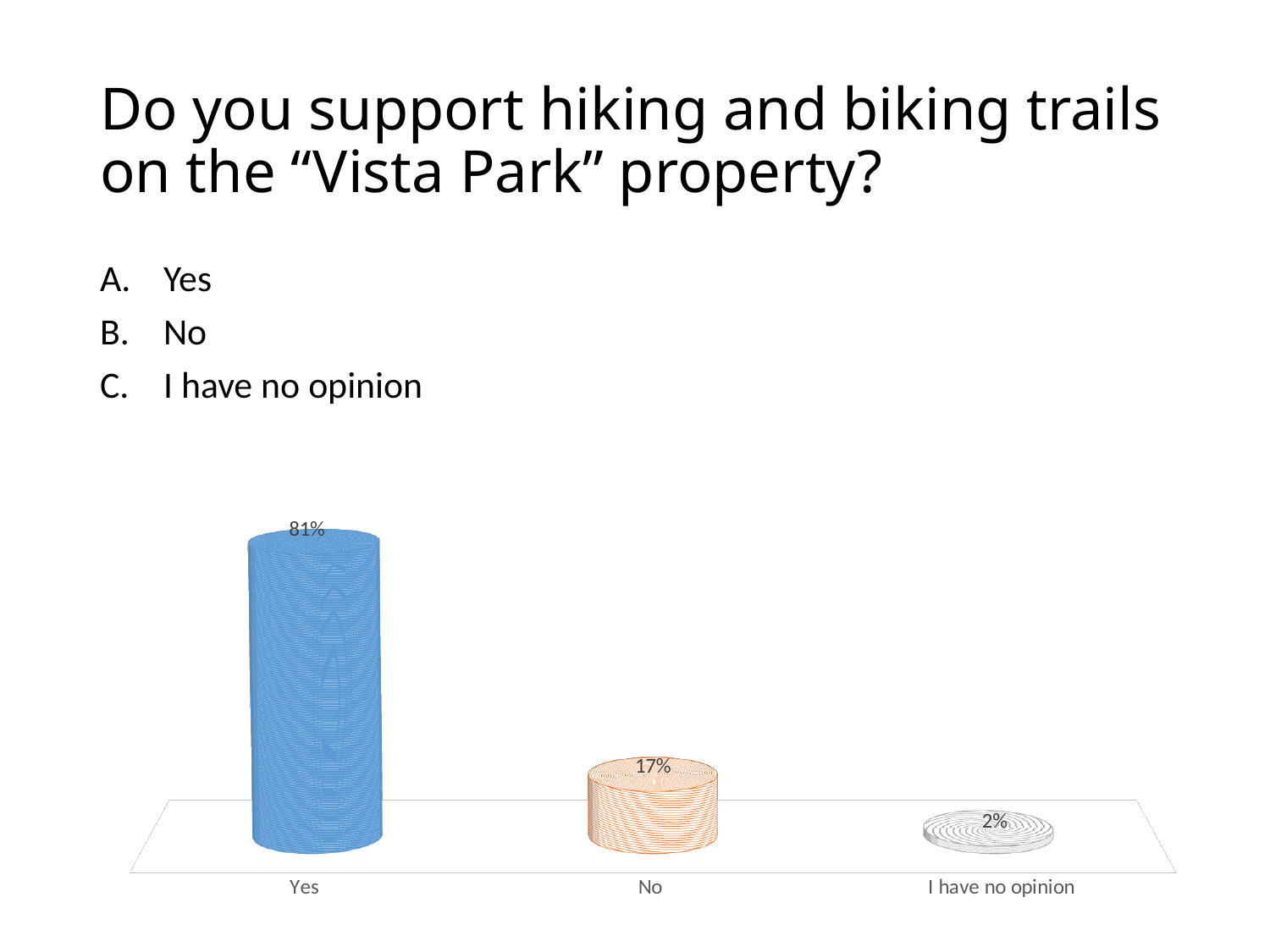
How many categories are shown in the chart? 3 What kind of chart is shown on the slide? Bar chart What is the value for "Yes"? 81% What is the difference between the values for "Yes" and "No"? 64% Which category has the highest value? Yes Do the values rise or fall from left to right along the x axis? Fall Which is larger, the value for "No" or the value for "I have no opinion"? No Which category has the lowest value? I have no opinion What is the value for "I have no opinion"? 2% What is the value for "No"? 17% What colour is the bar for "Yes"? Blue What is the difference between the values for "No" and "I have no opinion"? 15%